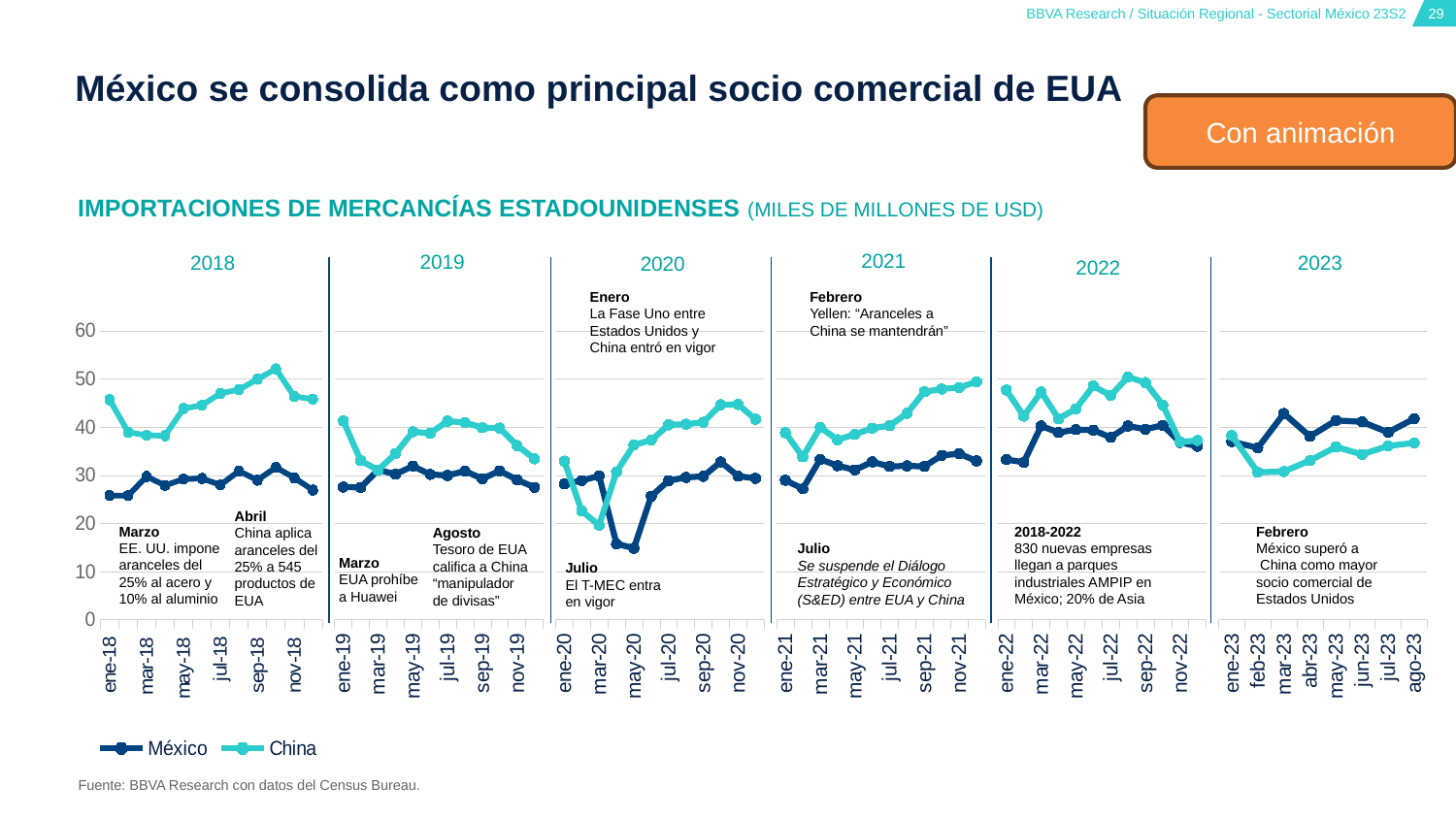
How many series does the legend list? 2 How many year panels (2018 through 2023) does the chart show? 6 In what units are the values on the chart expressed? Miles de millones de USD Is the value for México in ene-18 greater or less than 30? less In may-20, which series has the higher value, México or China? China Is the value for México in may-20 greater or less than 20? less Is the value for China in ene-22 greater or less than 40? greater Which two series are shown in the legend? México and China What kind of chart is used to show US merchandise imports from México and China? line chart Does the China series rise or fall from ene-18 to sep-18? rise In ago-23, which series has the higher value, México or China? México